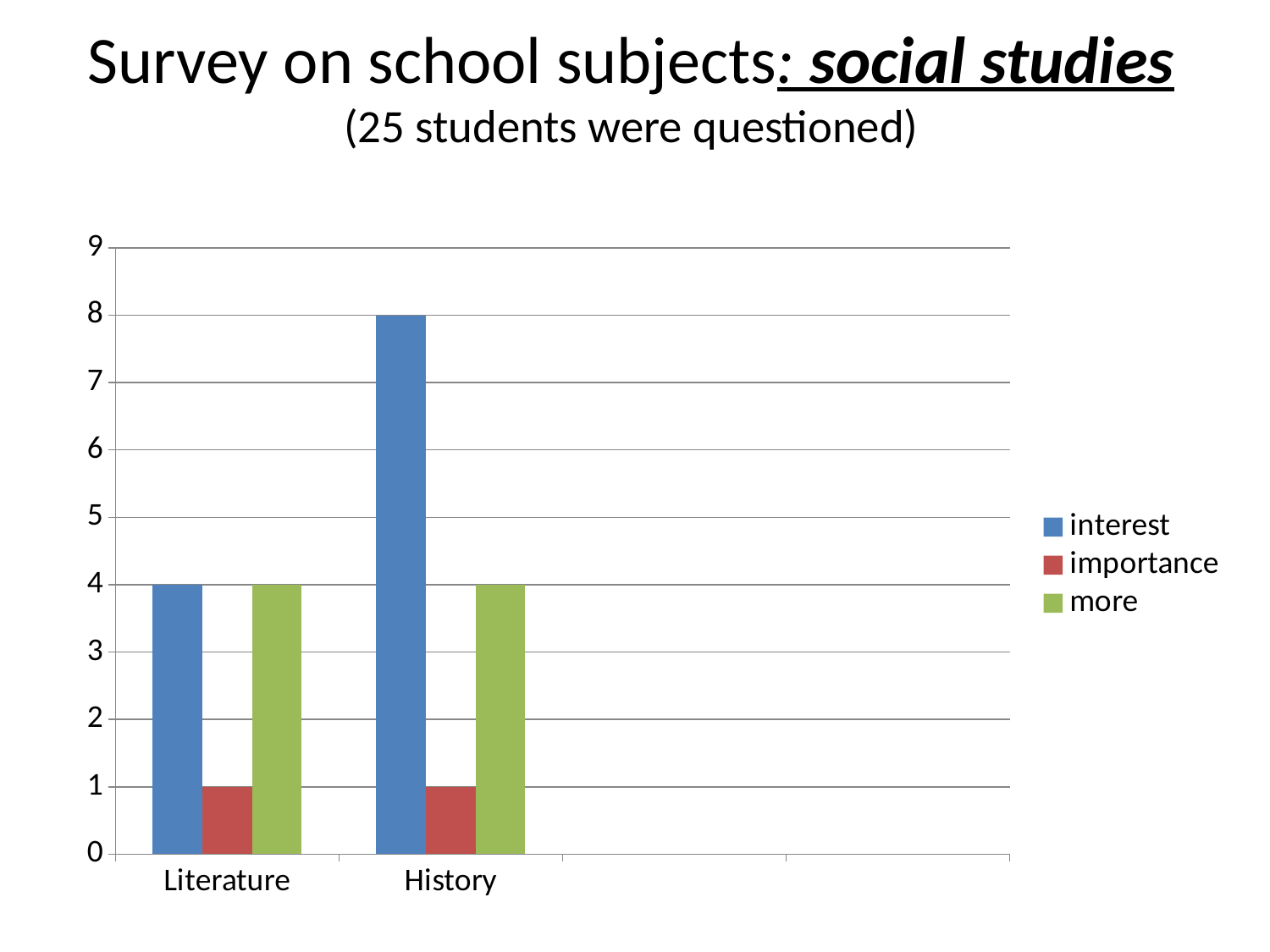
What is the value of the importance series for Literature? 1 How many subject categories are shown on the x axis? 2 Which series is shown in green in the legend? more What is the value of the interest series for Literature? 4 What kind of chart is shown on the slide? bar chart How many series does the legend list? 3 What is the value of the more series for History? 4 Is the value of the interest series for History greater or less than 5? greater Which series has the lowest value for History? importance What is the difference between the interest values for History and Literature? 4 What is the value of the interest series for History? 8 Which category has the higher value for the interest series? History